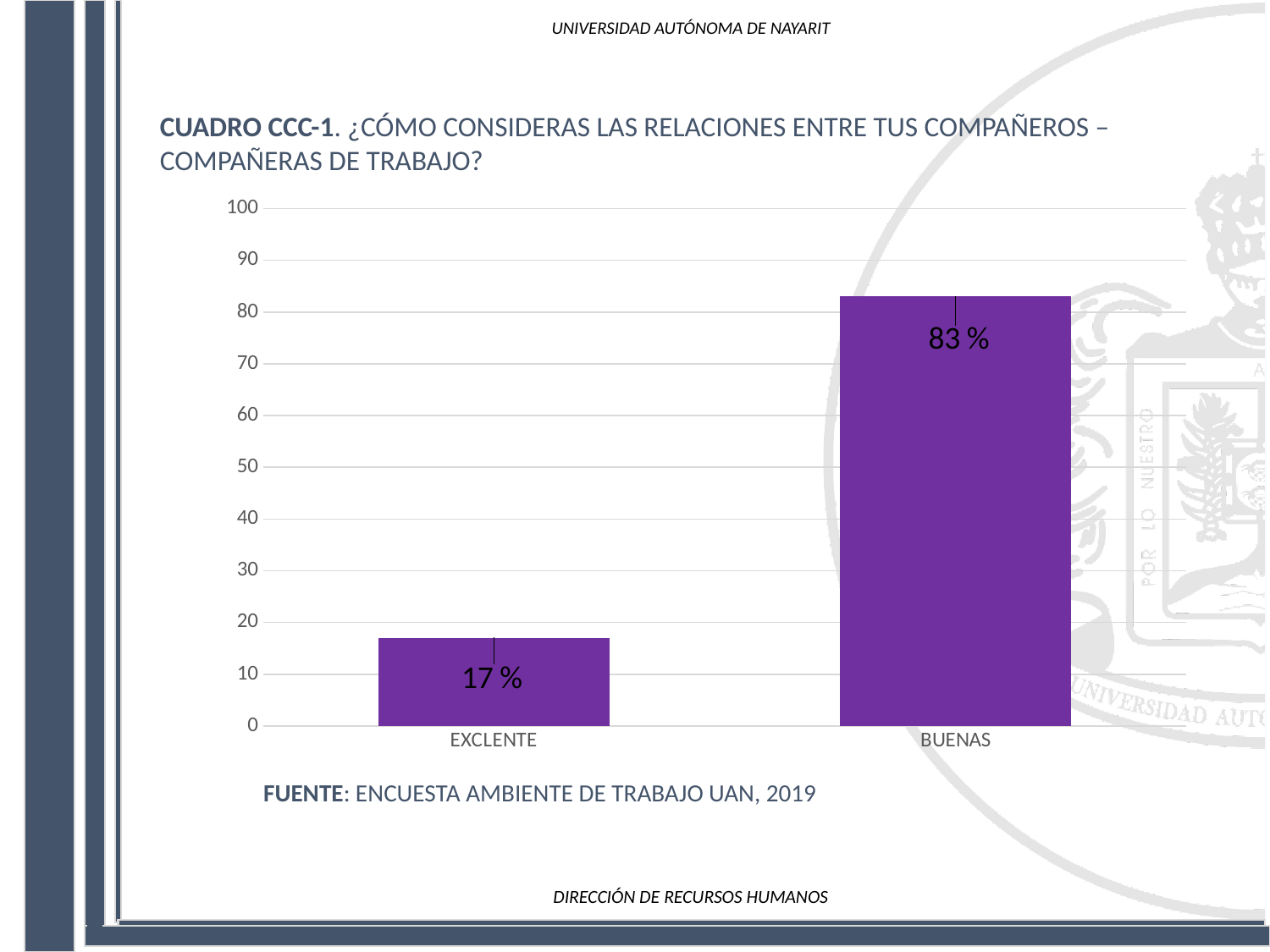
Is the value for EXCLENTE greater or less than 20? less Which is larger, the value for EXCLENTE or the value for BUENAS? BUENAS What is the value for BUENAS? 83 % Which category has the highest value? BUENAS What is the value for EXCLENTE? 17 % How many categories are shown on the x axis? 2 What is the difference between the values for BUENAS and EXCLENTE? 66 % What colour are the bars in the chart? purple What is the source cited below the chart? ENCUESTA AMBIENTE DE TRABAJO UAN, 2019 Which category has the lowest value? EXCLENTE Is the value for BUENAS greater or less than 80? greater What kind of chart is shown on the slide? bar chart